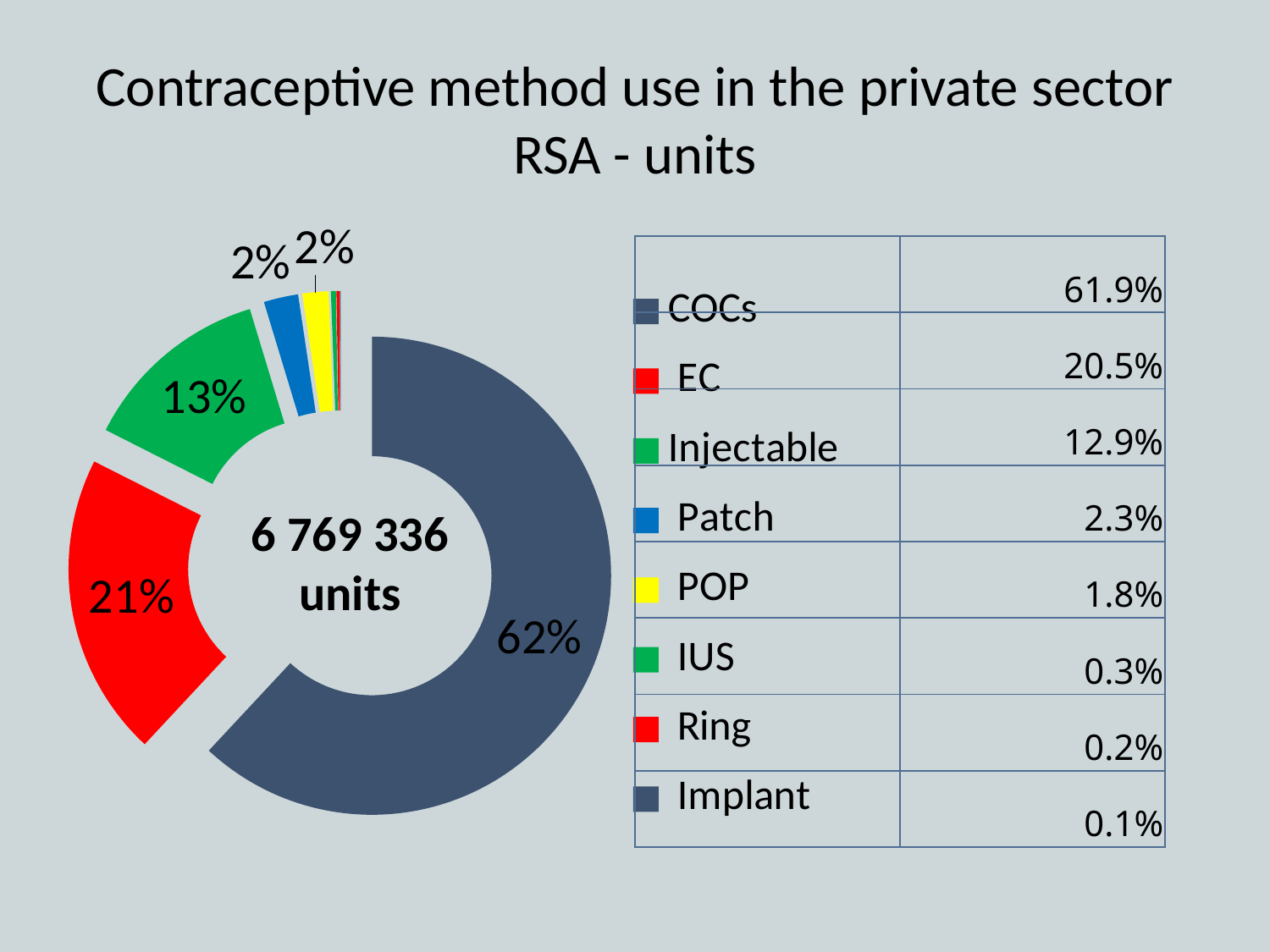
What percentage is shown for EC in the legend table? 20.5% What percentage is shown for COCs in the legend table? 61.9% What is the difference in percentage points between COCs and EC according to the legend table? 41.4% Which has a larger share, Injectable or Patch? Injectable What percentage is shown for Patch in the legend table? 2.3% What percentage is shown for Injectable in the legend table? 12.9% Which contraceptive method has the smallest share? Implant How many contraceptive methods are listed in the legend table? 8 What total number of units is printed in the centre of the chart? 6 769 336 units What percentage is shown for Implant in the legend table? 0.1% Which contraceptive method has the largest share? COCs What kind of chart is shown on the slide? Doughnut (pie) chart